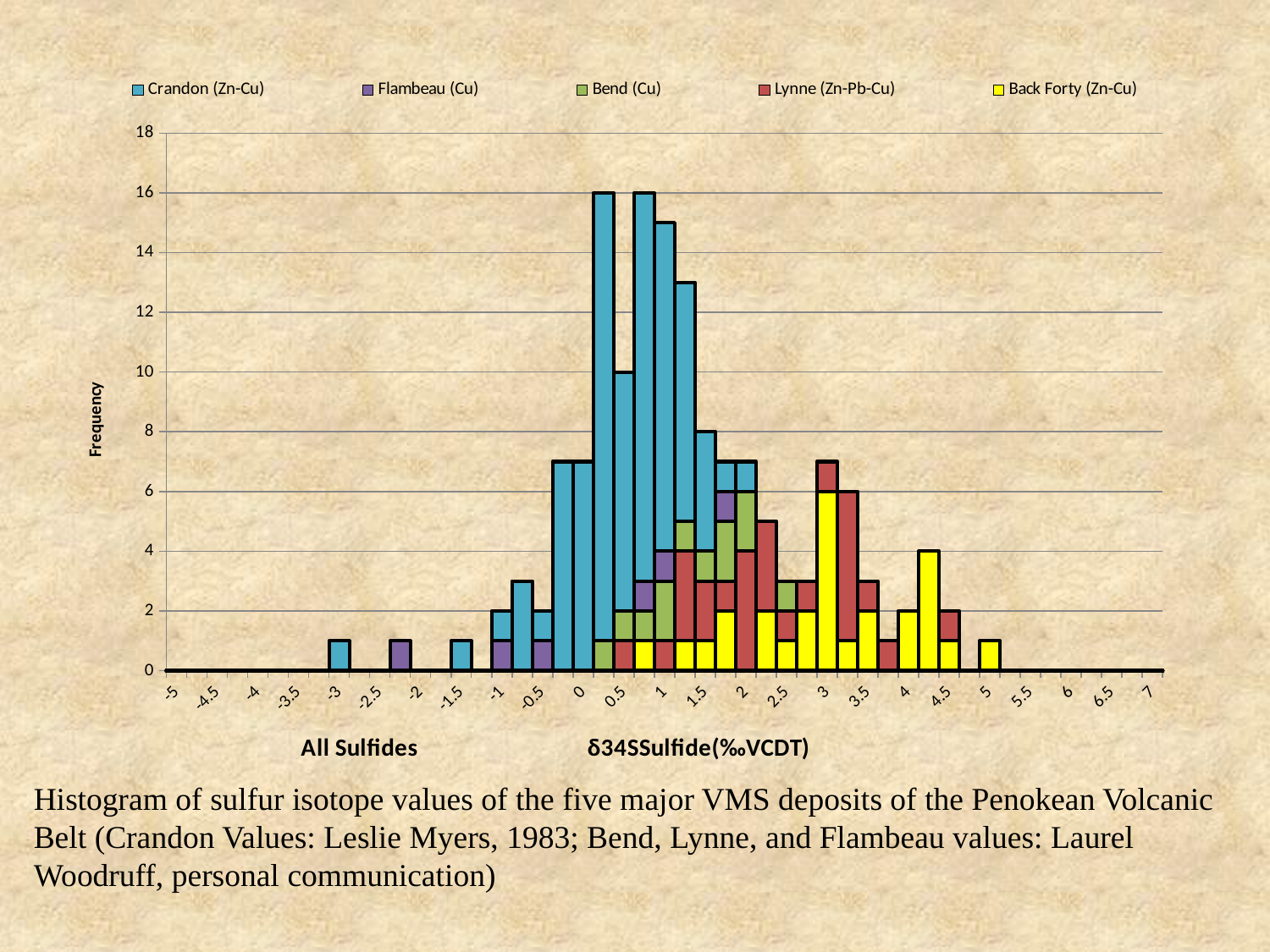
What is the highest frequency reached by any bar in the histogram? 16 Which series makes up the tallest bars in the histogram? Crandon (Zn-Cu) What are the five series named in the legend? Crandon (Zn-Cu), Flambeau (Cu), Bend (Cu), Lynne (Zn-Pb-Cu), Back Forty (Zn-Cu) How many series does the legend list? 5 Which series appears at the far left of the histogram, near -3 on the x axis? Crandon (Zn-Cu) What kind of chart is shown on the slide? Stacked bar chart (histogram) Is the tallest Lynne (Zn-Pb-Cu) bar greater or less than 10? less Is the tallest Back Forty (Zn-Cu) bar greater or less than 8? less What is the maximum value shown on the vertical axis? 18 Is the tallest bar in the histogram greater or less than 14? greater What is the title of the vertical axis? Frequency Which series appears at the far right of the histogram, near 5 on the x axis? Back Forty (Zn-Cu)